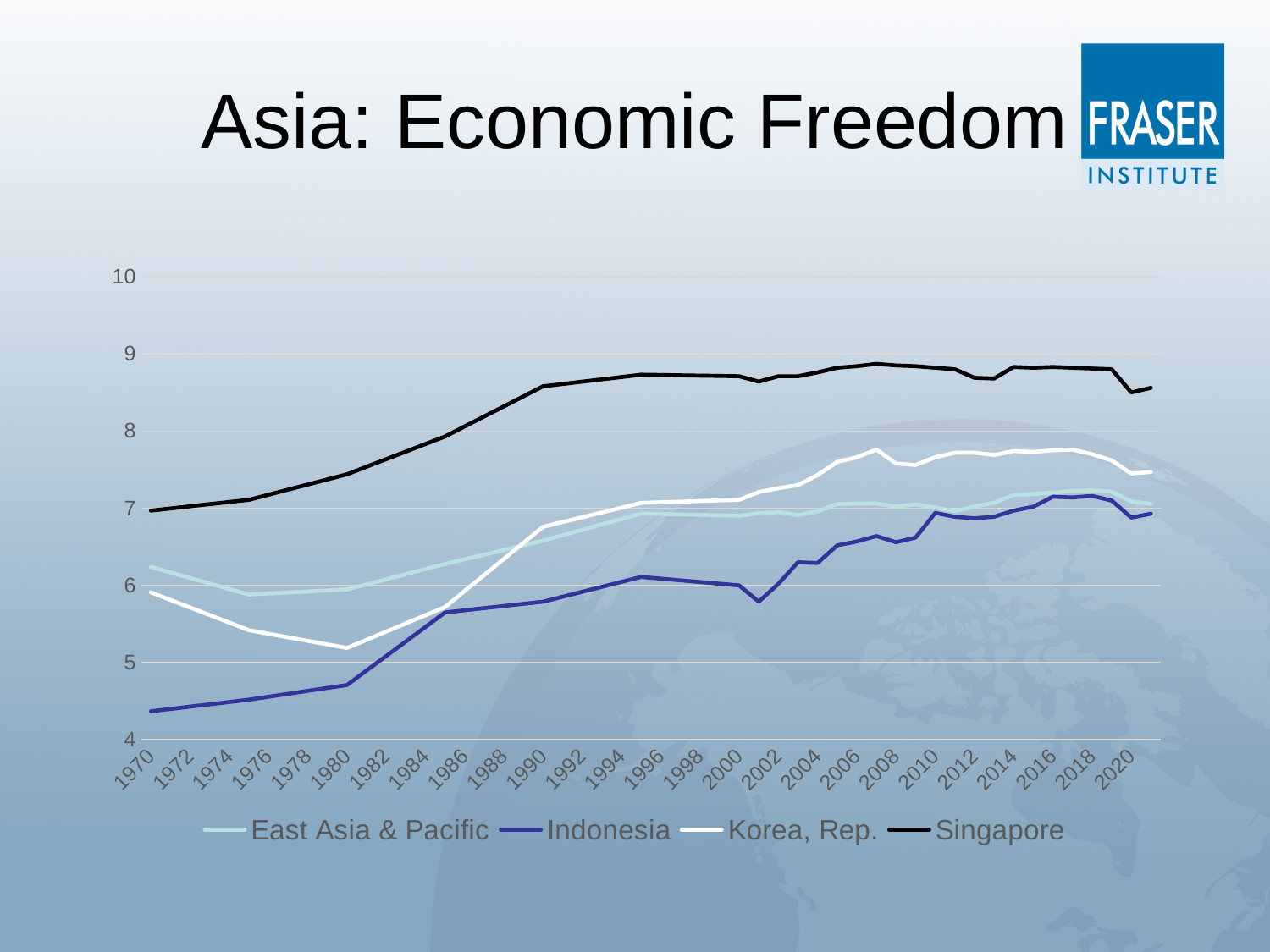
Is the value for Korea, Rep. in 1980 greater or less than 6? less How many series does the legend list? 4 Is the value for Singapore in 2010 greater or less than 8? greater Is the value for Indonesia in 1970 greater or less than 5? less What kind of chart is shown on the slide? line chart Which series are listed in the legend? East Asia & Pacific, Indonesia, Korea, Rep., Singapore What is the title of the chart? Asia: Economic Freedom Which series has the lowest value in 1970? Indonesia In 1970, which is higher: East Asia & Pacific or Korea, Rep.? East Asia & Pacific Which series has the highest value in 2020? Singapore Does the Indonesia line rise or fall from 1970 to 1990? rise